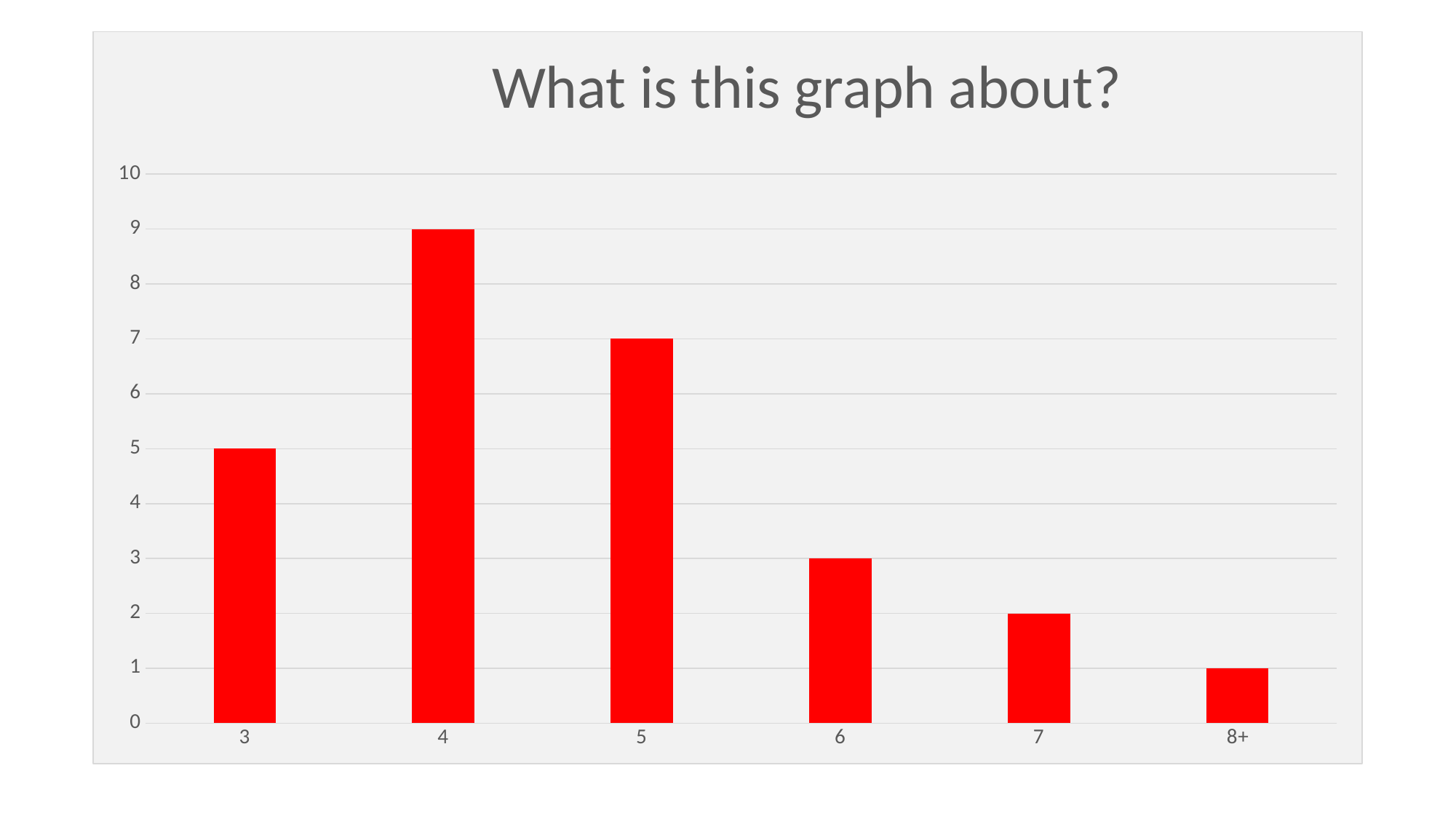
Do the values rise or fall from category 5 to category 8+? Fall What is the title of the chart? What is this graph about? What is the difference between the values for category 4 and category 5? 2 What is the value of the bar for category 4? 9 How many categories are shown on the x axis? 6 Which category has the lowest bar? 8+ What is the difference between the values for category 3 and category 6? 2 What is the value of the bar for category 8+? 1 Which category has the highest bar? 4 What kind of chart is shown on the slide? Bar chart What is the value of the bar for category 3? 5 Which is larger, the value for category 5 or the value for category 7? 5